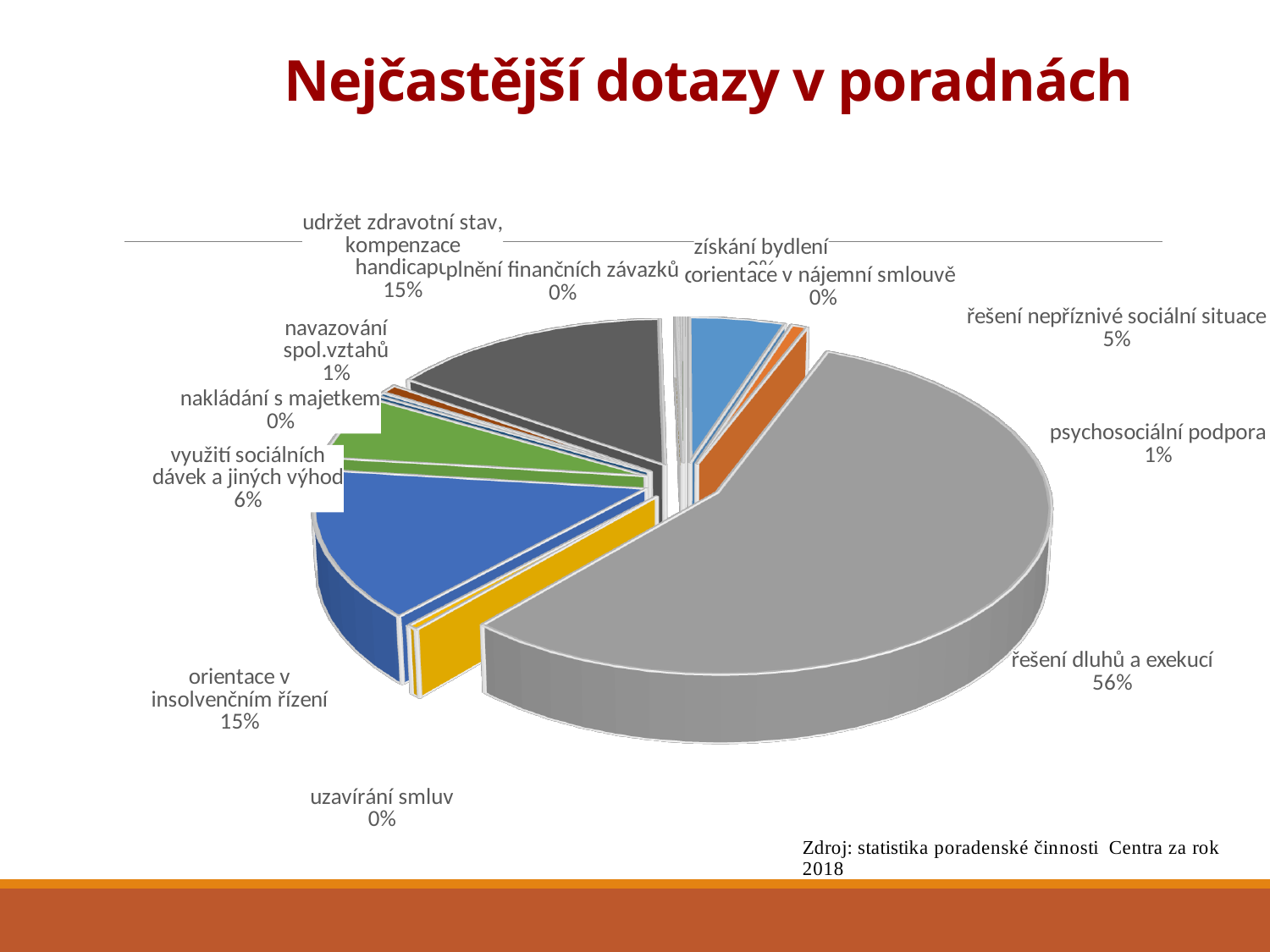
What is the value shown for "psychosociální podpora"? 1% How many categories are labelled on the pie chart? 12 What kind of chart is shown on the slide? pie chart Which is larger, "využití sociálních dávek a jiných výhod" or "řešení nepříznivé sociální situace"? využití sociálních dávek a jiných výhod What is the value shown for "orientace v insolvenčním řízení"? 15% What is the value shown for "využití sociálních dávek a jiných výhod"? 6% What is the difference between the shares of "řešení dluhů a exekucí" and "orientace v insolvenčním řízení"? 41% What is the value shown for "řešení nepříznivé sociální situace"? 5% What is the value shown for "udržet zdravotní stav, kompenzace handicapu"? 15% Which category has the largest share of the pie? řešení dluhů a exekucí What is the title of the chart? Nejčastější dotazy v poradnách What share of the pie does "řešení dluhů a exekucí" represent? 56%